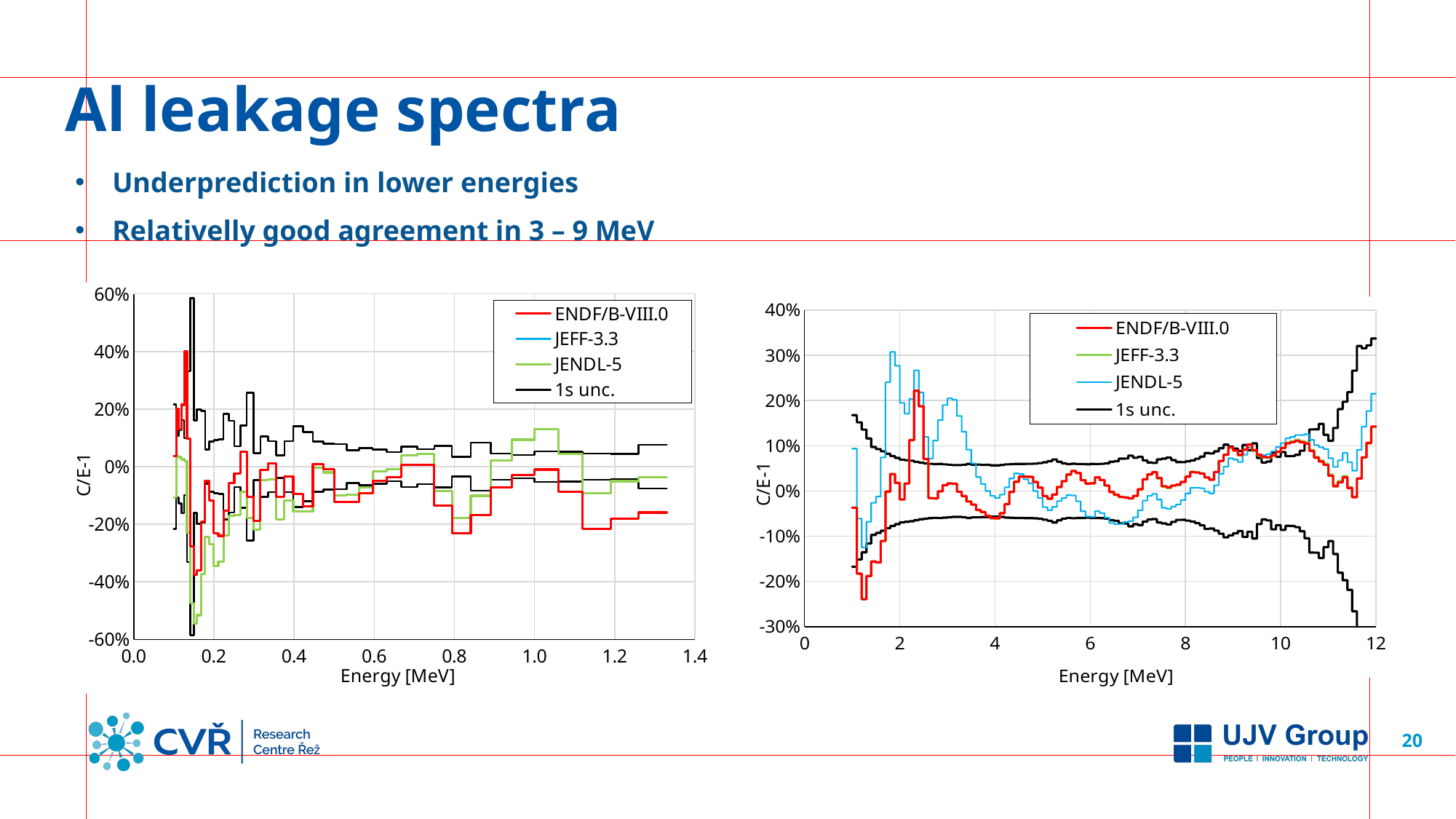
In the right chart, is the value of ENDF/B-VIII.0 at 12 MeV greater or less than 10%? greater In the right chart, is the upper 1s unc. curve at 12 MeV greater or less than 30%? greater What kind of chart is the right chart on the slide? line chart How many series does the legend of the right chart list? 4 In the right chart, is the value of JENDL-5 at 12 MeV greater or less than 10%? greater What is the x-axis label of the left chart? Energy [MeV] What kind of chart is the left chart on the slide? line chart How many series does the legend of the left chart list? 4 What is the y-axis label of the right chart? C/E-1